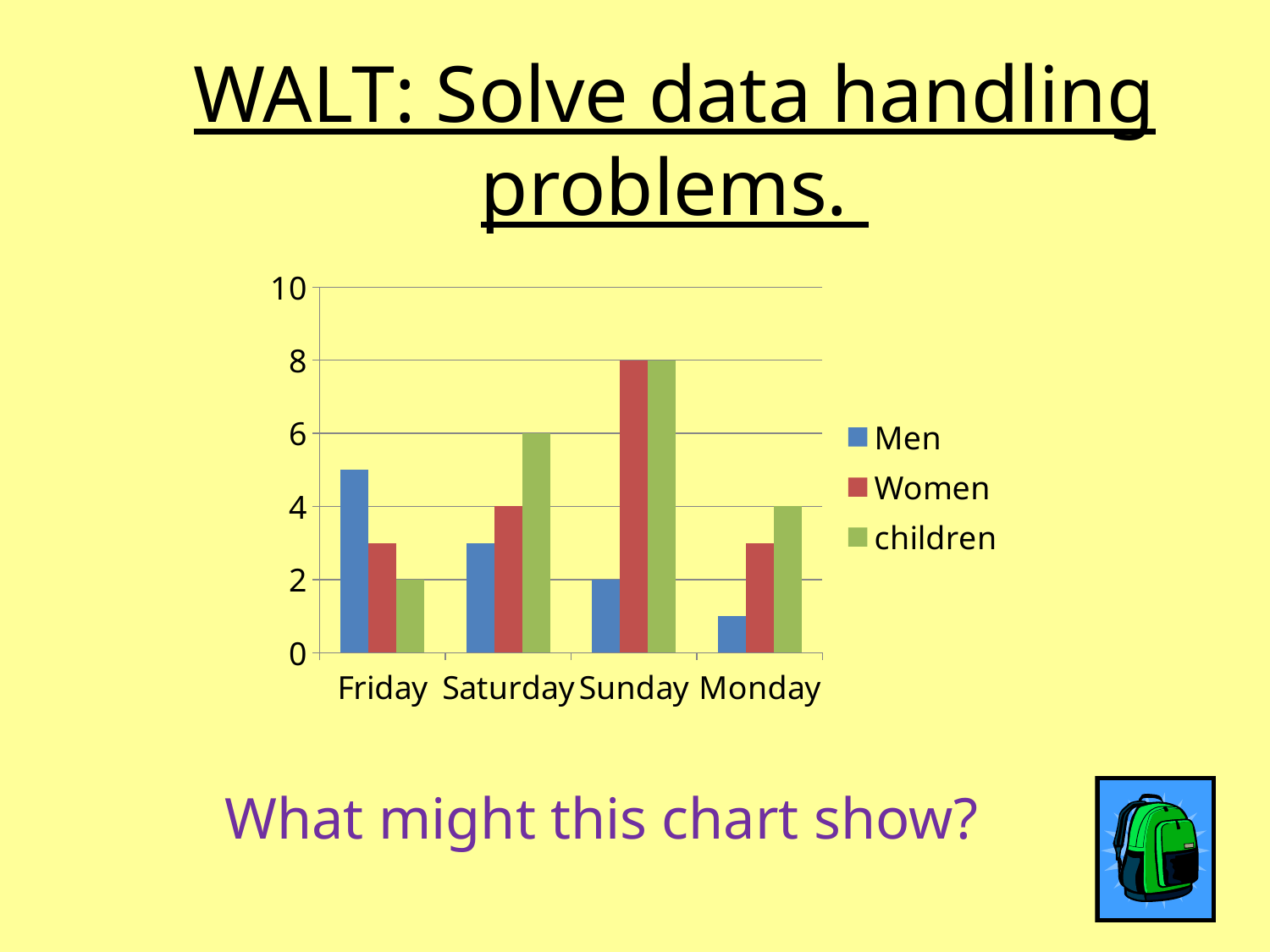
What kind of chart is shown on the slide? bar chart On which day is the value for Men lowest? Monday How many categories are shown on the x axis? 4 How many series does the legend list? 3 What is the difference between the value for children on Sunday and the value for children on Friday? 6 What is the value for Men on Sunday? 2 What is the value for children on Monday? 4 What is the value for children on Saturday? 6 Is the value for Men on Friday greater or less than 4? greater On which day is the value for Men highest? Friday What is the value for Women on Sunday? 8 Which is larger on Saturday, the value for Men or the value for children? children